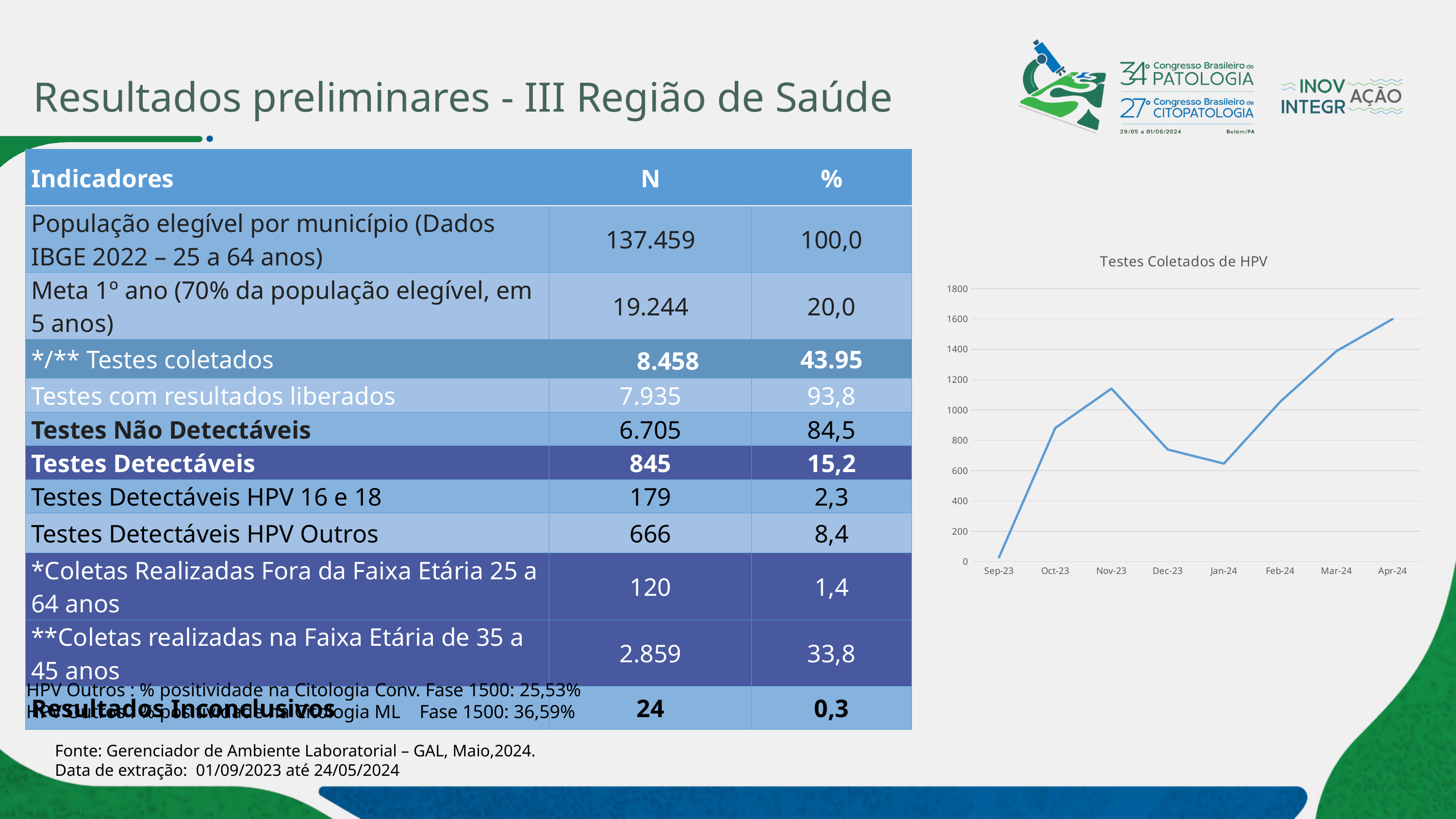
What kind of chart is "Testes Coletados de HPV"? line chart In the "Testes Coletados de HPV" chart, which month has the lowest value? Sep-23 In the "Testes Coletados de HPV" chart, which is larger, the value for Nov-23 or the value for Dec-23? Nov-23 In the "Testes Coletados de HPV" chart, do the values rise or fall from Jan-24 to Apr-24? rise In the "Testes Coletados de HPV" chart, is the value for Jan-24 greater or less than 800? less In the "Testes Coletados de HPV" chart, is the value for Nov-23 greater or less than 1000? greater In the "Testes Coletados de HPV" chart, is the value for Oct-23 greater or less than 1000? less How many months are plotted on the x axis of the "Testes Coletados de HPV" chart? 8 What is the title of the chart on the right of the slide? Testes Coletados de HPV In the "Testes Coletados de HPV" chart, which month has the highest value? Apr-24 In the "Testes Coletados de HPV" chart, which is larger, the value for Mar-24 or the value for Feb-24? Mar-24